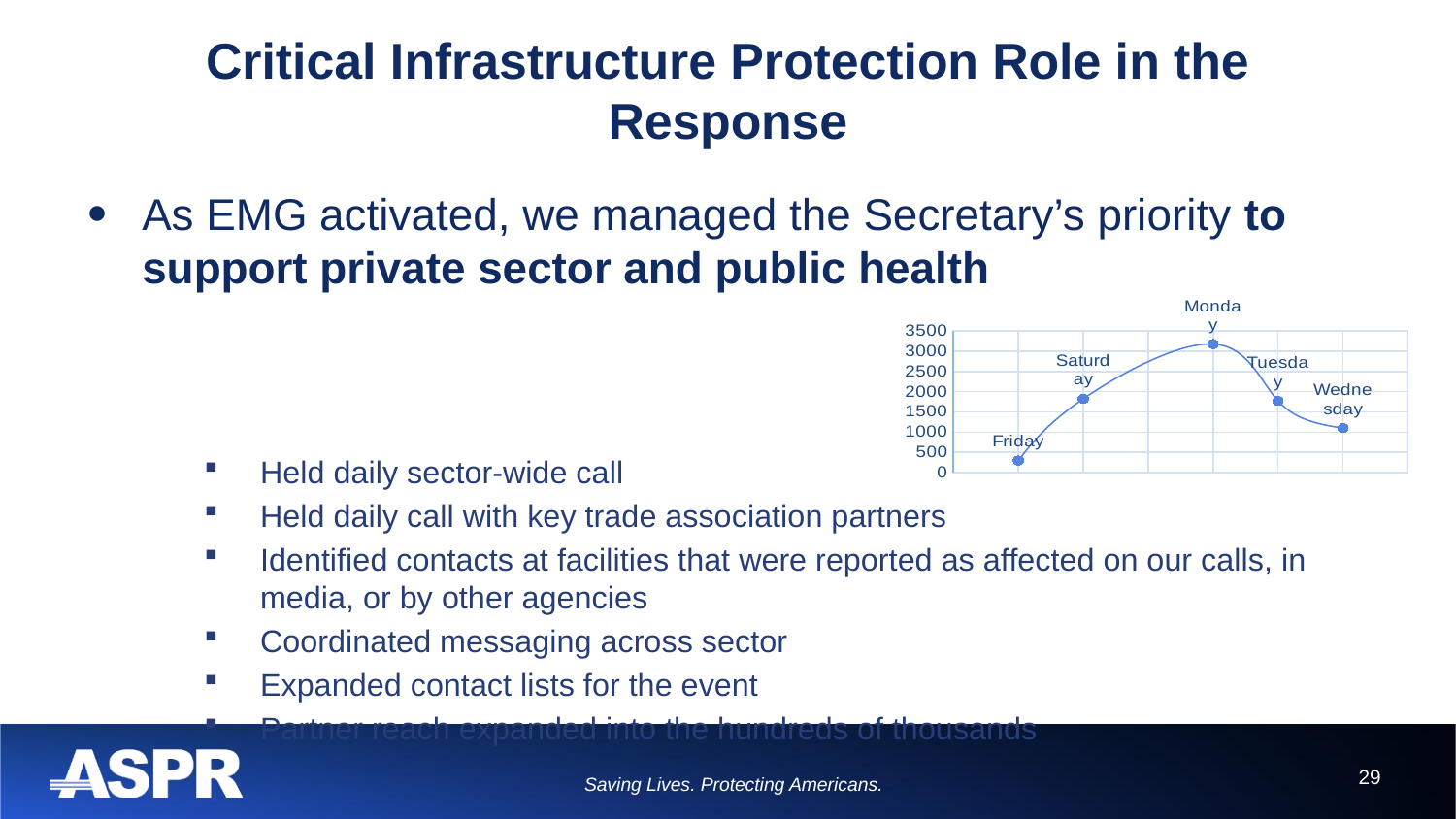
Which day has the highest value on the line chart? Monday Is the value for Friday greater or less than 500? less Which is larger on the line chart, the value for Saturday or the value for Friday? Saturday Is the value for Saturday greater or less than 1500? greater Does the line rise or fall from Monday to Wednesday? fall How many data points are plotted on the line chart? 5 What kind of chart is shown on the slide? line chart Is the value for Monday greater or less than 2500? greater What is the highest value shown on the vertical axis of the line chart? 3500 Which day has the lowest value on the line chart? Friday Which is larger on the line chart, the value for Monday or the value for Wednesday? Monday